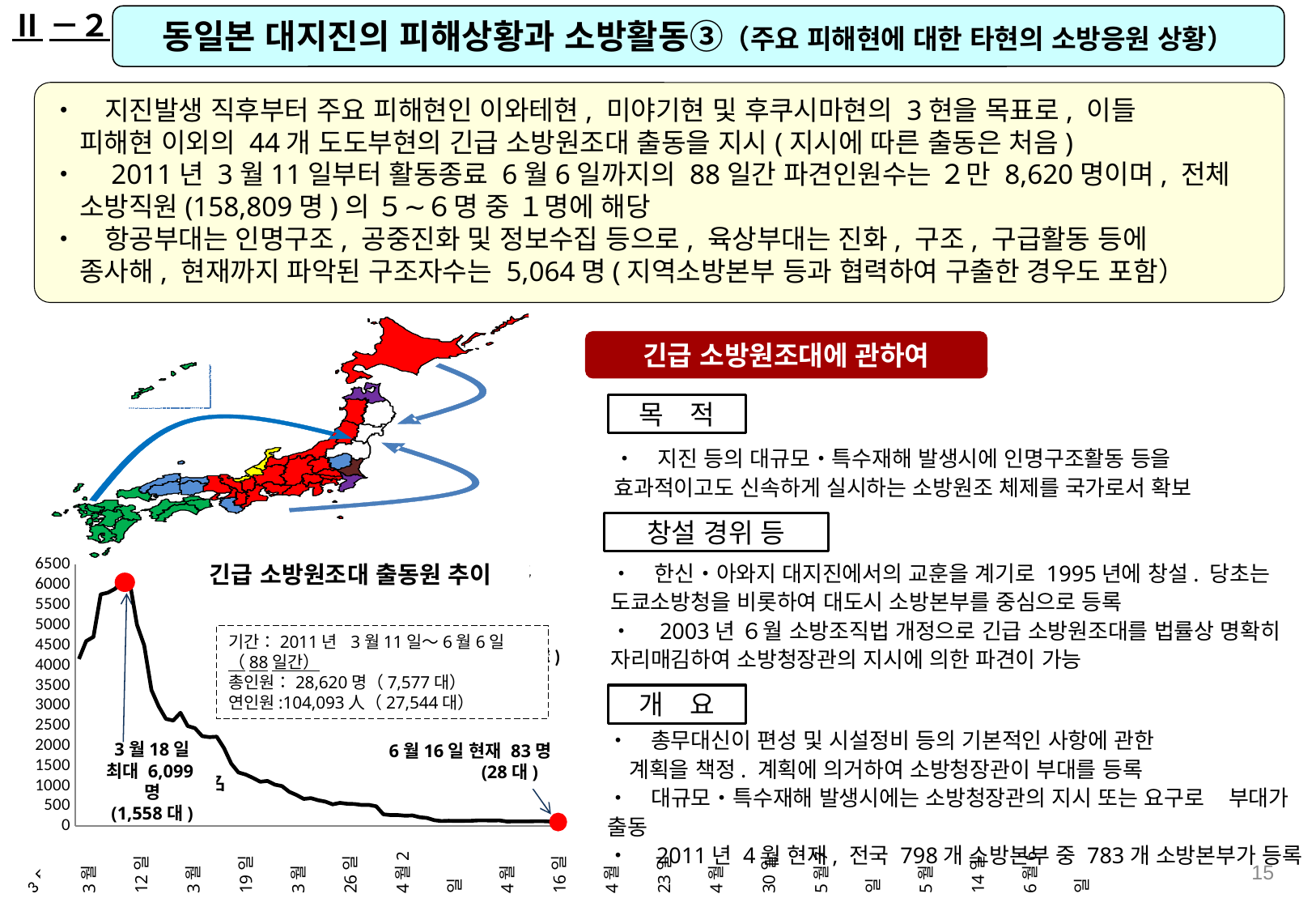
In the chart "긴급 소방원조대 출동원 추이", how many vehicles (대) are labelled for 6월 16일 현재? 28대 In the chart "긴급 소방원조대 출동원 추이", which is larger: the value on 3월 18일 or the value on 6월 16일? 3월 18일 What kind of chart is "긴급 소방원조대 출동원 추이"? line chart In the chart "긴급 소방원조대 출동원 추이", what is the maximum number of dispatched personnel shown? 6,099명 In the chart "긴급 소방원조대 출동원 추이", what is the highest tick value shown on the y axis? 6500 In the chart "긴급 소방원조대 출동원 추이", how many personnel are shown for 6월 16일 현재? 83명 In the chart "긴급 소방원조대 출동원 추이", what is the difference between the peak value on 3월 18일 and the value on 6월 16일? 6,016명 In the chart "긴급 소방원조대 출동원 추이", on which date does the peak of 6,099명 occur? 3월 18일 In the chart "긴급 소방원조대 출동원 추이", is the peak value greater or less than 6000? greater What is the title of the chart at the bottom left of the slide? 긴급 소방원조대 출동원 추이 In the chart "긴급 소방원조대 출동원 추이", after the peak on 3월 18일, do the values rise or fall along the x axis? fall In the chart "긴급 소방원조대 출동원 추이", how many vehicles (대) are labelled at the 3월 18일 peak? 1,558대